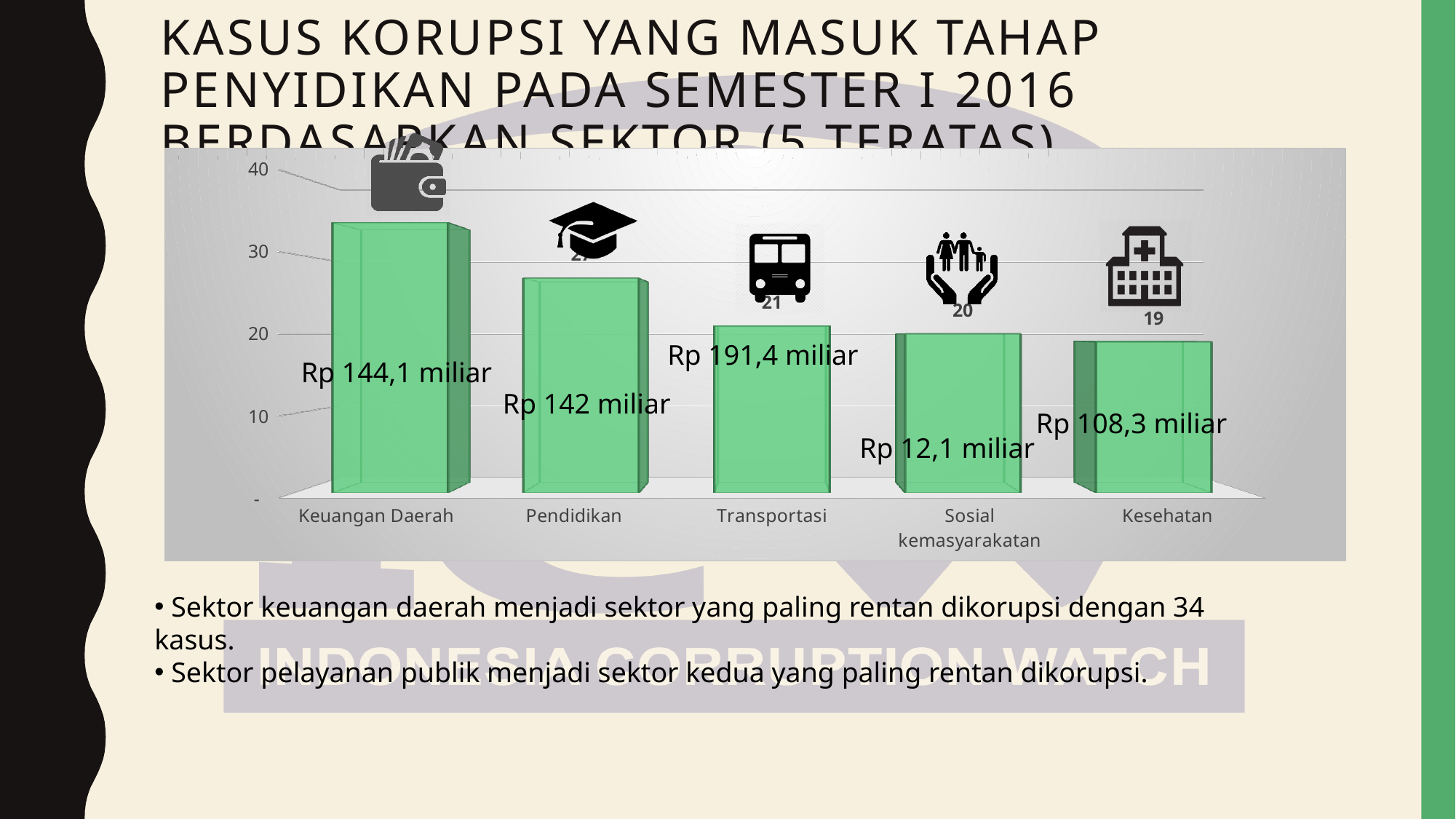
Is the value for Keuangan Daerah greater or less than 30? greater What is the value shown for Transportasi? 21 Is the value for Pendidikan greater or less than 30? less Which sector has the lowest bar in the chart? Kesehatan What kind of chart is shown on the slide? bar chart What is the difference between the values for Transportasi and Kesehatan? 2 Which sector has the highest bar in the chart? Keuangan Daerah Do the bar values rise or fall from left to right across the sectors? fall What is the value shown for Sosial kemasyarakatan? 20 How many sectors (categories) are shown in the chart? 5 Which is larger, the value for Transportasi or the value for Sosial kemasyarakatan? Transportasi What is the value shown for Kesehatan? 19